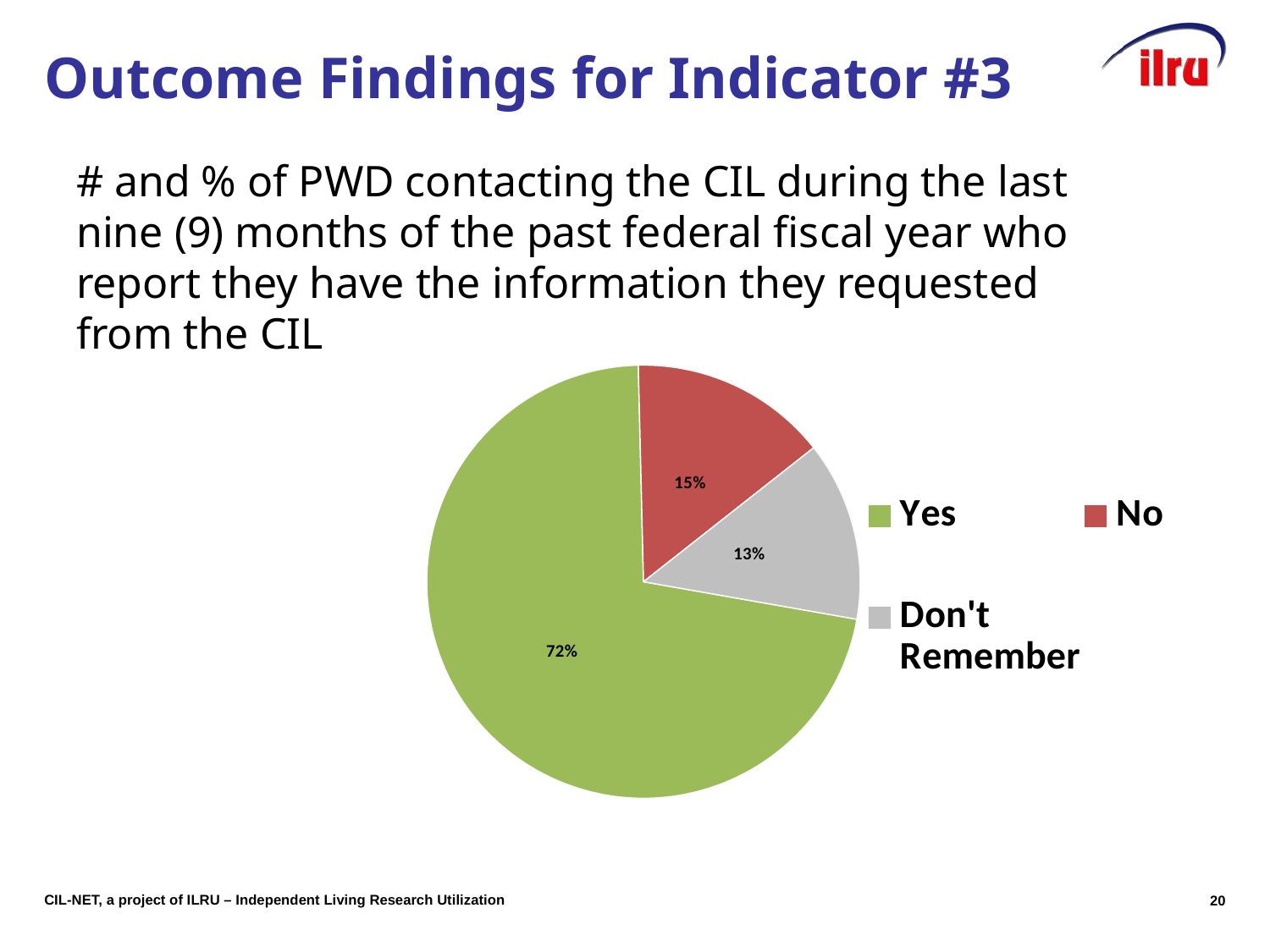
Which category has the smallest share of the pie? Don't Remember What is the difference in percentage points between the "No" slice and the "Don't Remember" slice? 2 Which is larger, the "No" slice or the "Don't Remember" slice? No What percentage of the pie is the "Don't Remember" slice? 13% What percentage of the pie is the "Yes" slice? 72% What percentage of the pie is the "No" slice? 15% How many entries does the legend list? 3 What is the difference in percentage points between the "Yes" slice and the "No" slice? 57 Which category has the largest share of the pie? Yes How many slices does the pie chart have? 3 What kind of chart is shown on the slide? pie chart What colour is the "Yes" slice in the pie chart? green